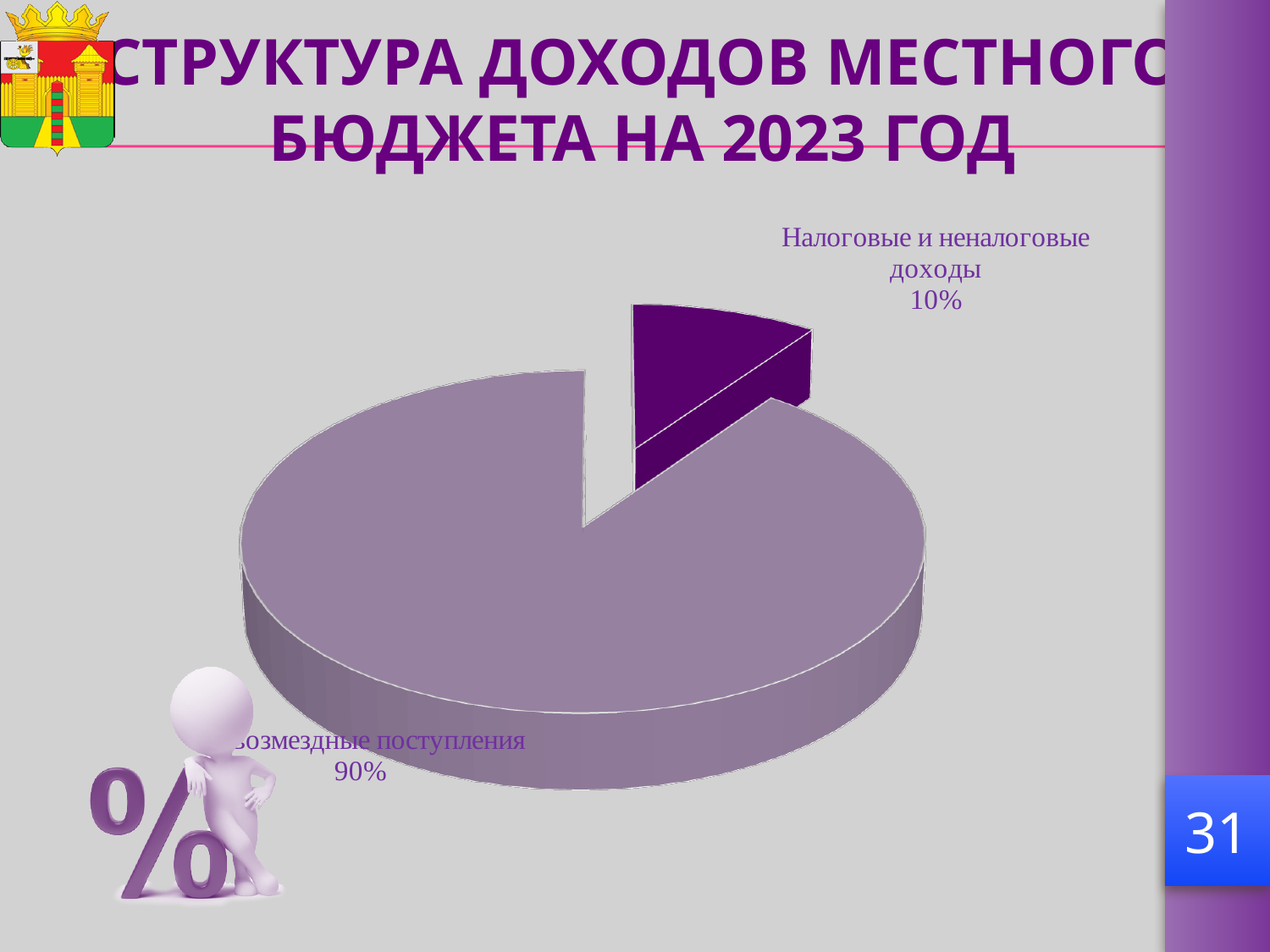
Which is larger: the share for "Налоговые и неналоговые доходы" or the share for "Безвозмездные поступления"? Безвозмездные поступления What share of the pie is labelled "Налоговые и неналоговые доходы"? 10% Which slice is drawn in the darker purple colour and pulled out from the pie? Налоговые и неналоговые доходы How many slices does the pie chart have? 2 Which slice of the pie is the smallest? Налоговые и неналоговые доходы What is the difference in percentage points between the "Безвозмездные поступления" slice and the "Налоговые и неналоговые доходы" slice? 80 percentage points What is the title of the slide containing the pie chart? СТРУКТУРА ДОХОДОВ МЕСТНОГО БЮДЖЕТА НА 2023 ГОД What is the total of the two slice percentages shown on the pie chart? 100% What share of the pie is labelled "Безвозмездные поступления"? 90% Which slice of the pie is the largest? Безвозмездные поступления What kind of chart is shown on the slide? Pie chart